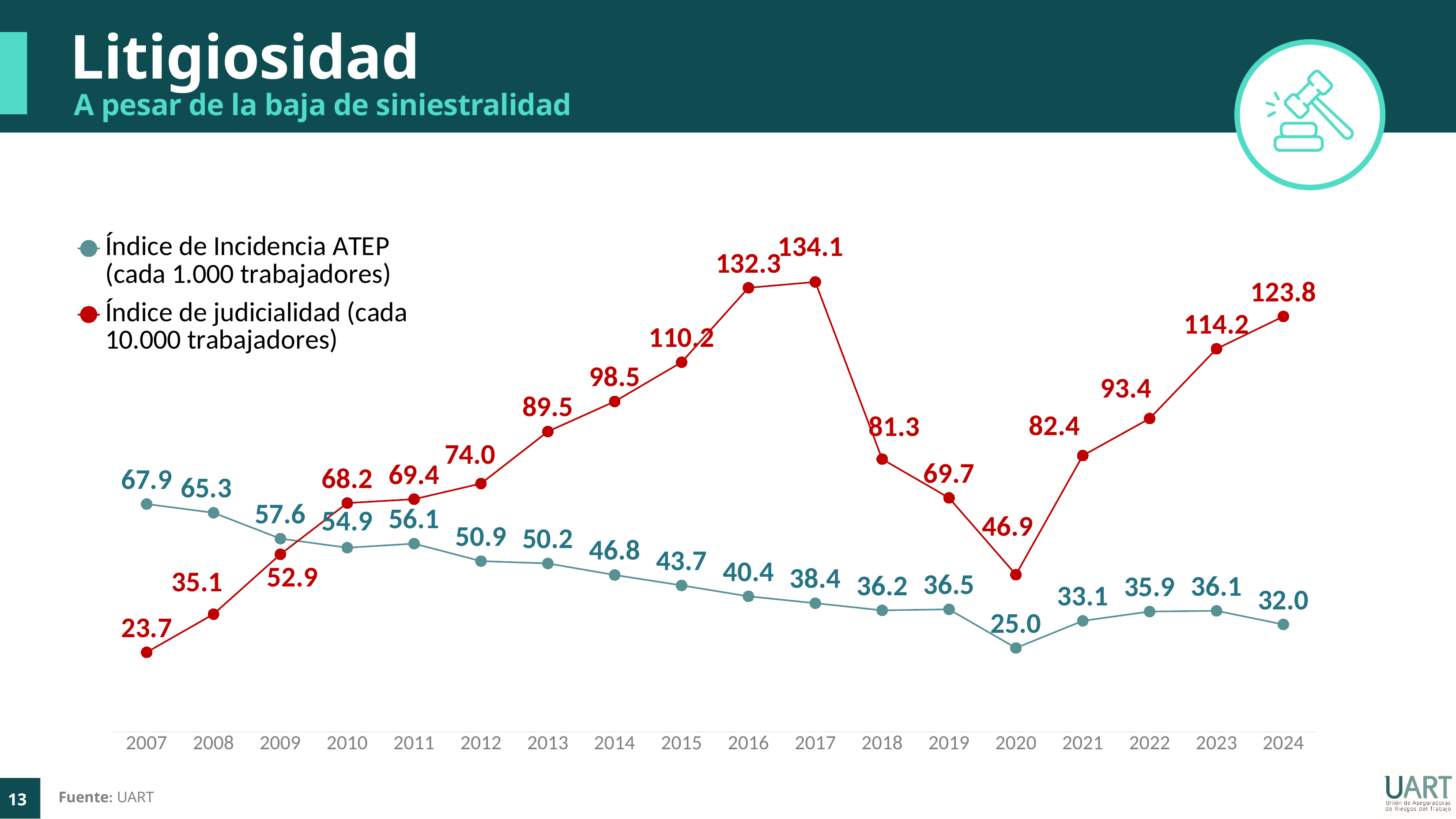
What is the value of the Índice de Incidencia ATEP in 2020? 25.0 What is the value of the Índice de judicialidad in 2017? 134.1 How many series does the legend list? 2 Does the Índice de Incidencia ATEP generally rise or fall from 2007 to 2024? Fall In which year is the Índice de Incidencia ATEP lowest? 2020 What is the difference between the Índice de judicialidad in 2017 and in 2018? 52.8 Which is larger in 2009: the Índice de Incidencia ATEP or the Índice de judicialidad? Índice de Incidencia ATEP In which year is the Índice de judicialidad highest? 2017 How many years are shown on the x axis? 18 What colour is the line for the Índice de judicialidad? Red What type of chart is shown on the slide? Line chart What is the value of the Índice de judicialidad in 2024? 123.8